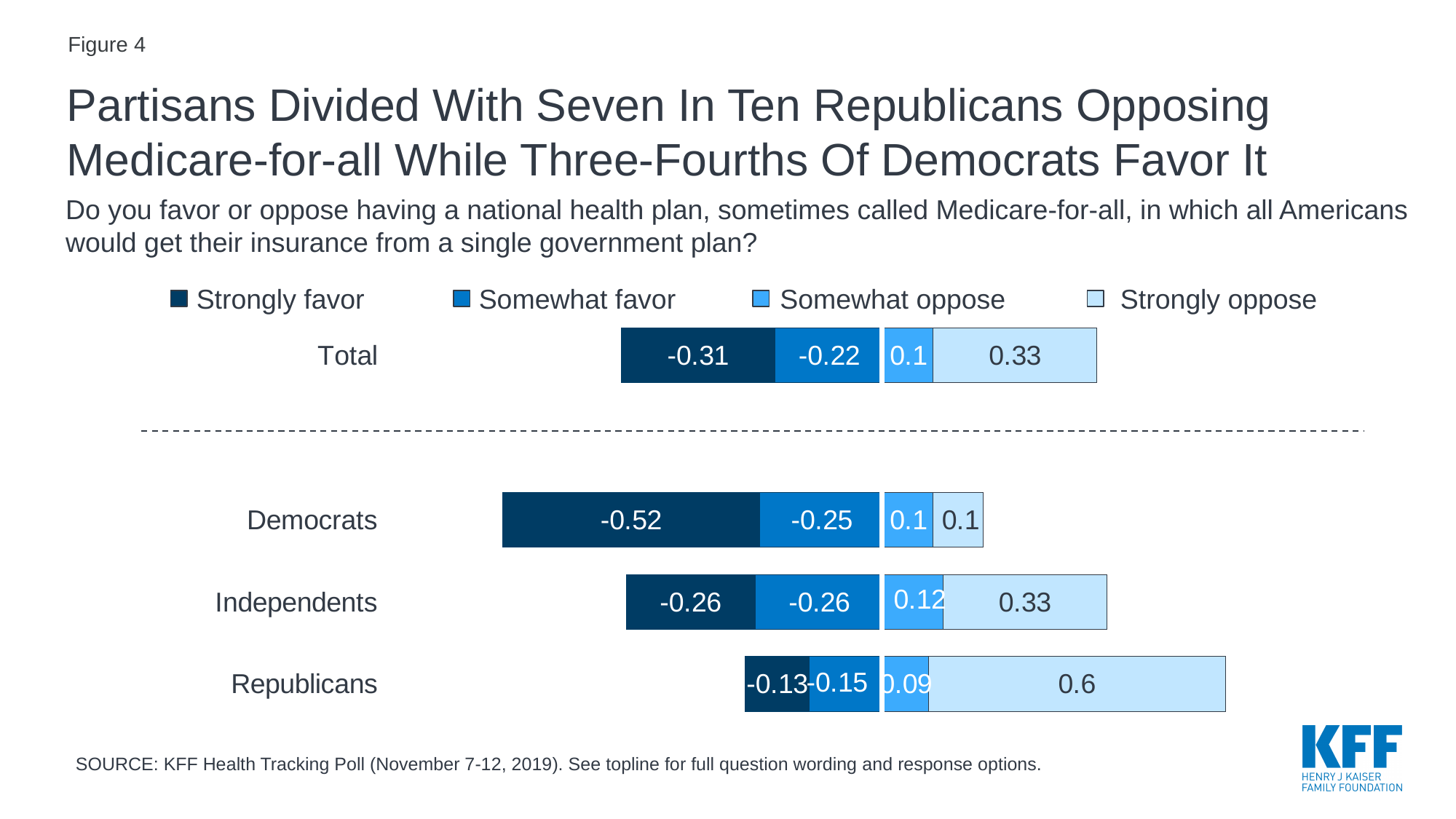
What is the Somewhat favor value for Total? -0.22 What kind of chart is shown on the slide? Stacked bar chart Which group has the largest Strongly favor segment? Democrats What is the Strongly oppose value for Republicans? 0.6 What is the Strongly favor value for Democrats? -0.52 Which group has the largest Strongly oppose value? Republicans Which group has the smallest Strongly oppose value? Democrats How many series does the legend list? 4 What is the Somewhat oppose value for Independents? 0.12 How many groups (bars) are shown in the chart? 4 Is the Strongly oppose segment larger for Independents or for Democrats? Independents What is the difference between the Strongly oppose values for Republicans and Independents? 0.27